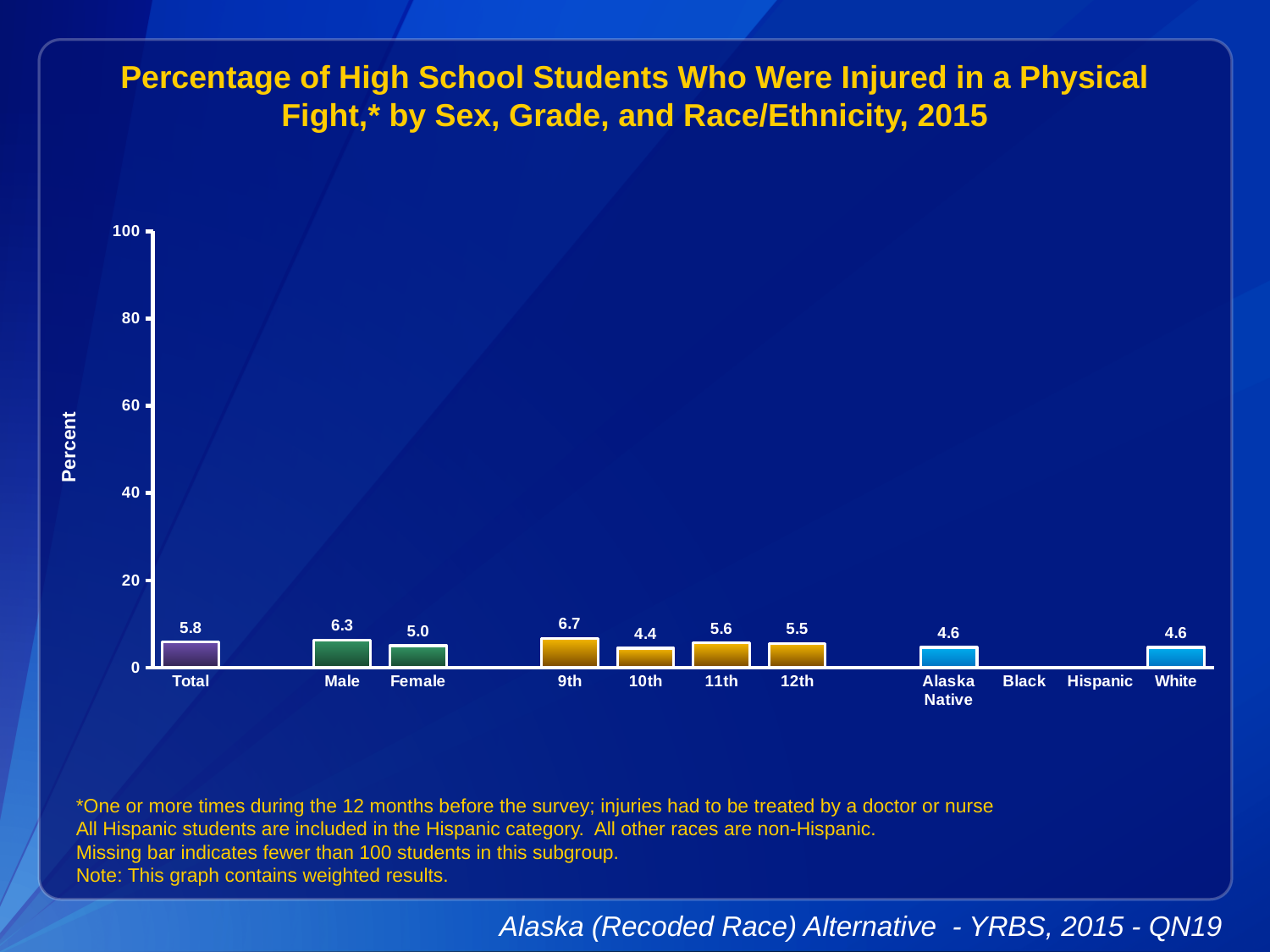
What is the label of the y axis? Percent Which is larger, the value for 11th or the value for 12th? 11th Is the value for 9th greater or less than 20? less What is the value for Total? 5.8 What is the value for 10th grade? 4.4 What kind of chart is shown? bar chart How many categories have a bar plotted? 9 What is the value for Male? 6.3 Which category has the lowest plotted value? 10th Which category has the highest value? 9th What is the difference between the Male and Female values? 1.3 What is the value for White? 4.6